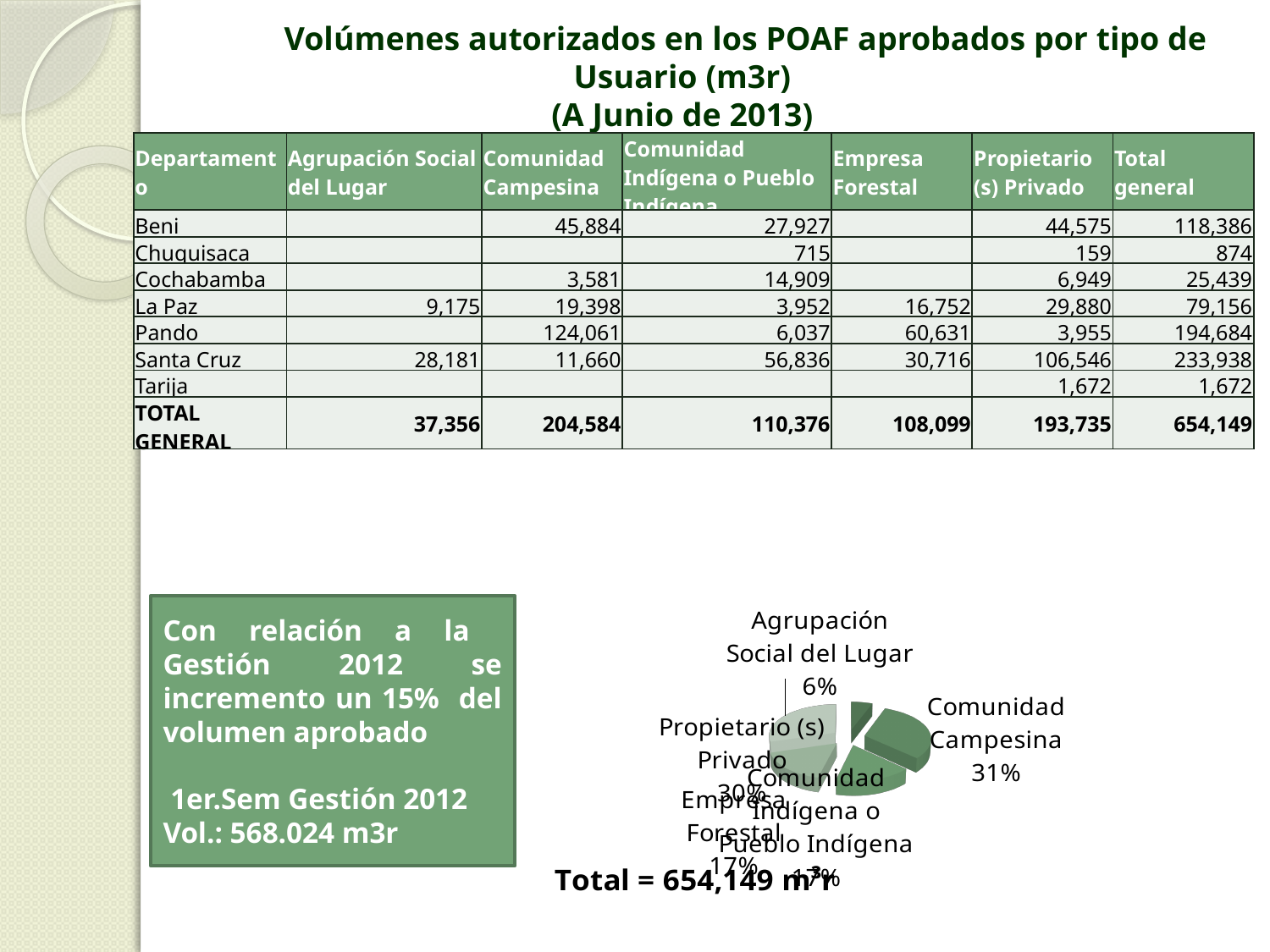
In the pie chart, what is the difference in percentage points between Propietario (s) Privado and Empresa Forestal? 13% In the pie chart, which is larger: Comunidad Campesina or Agrupación Social del Lugar? Comunidad Campesina Which slice of the pie chart is the largest? Comunidad Campesina In the pie chart, what share does Agrupación Social del Lugar have? 6% In the pie chart, what share does Comunidad Campesina have? 31% What kind of chart is shown at the bottom right of the slide? pie chart In the pie chart, what is the difference in percentage points between Comunidad Campesina and Agrupación Social del Lugar? 25% How many slices does the pie chart have? 5 In the pie chart, what share does Propietario (s) Privado have? 30% What total is printed below the pie chart? Total = 654,149 m3r Which slice of the pie chart is the smallest? Agrupación Social del Lugar